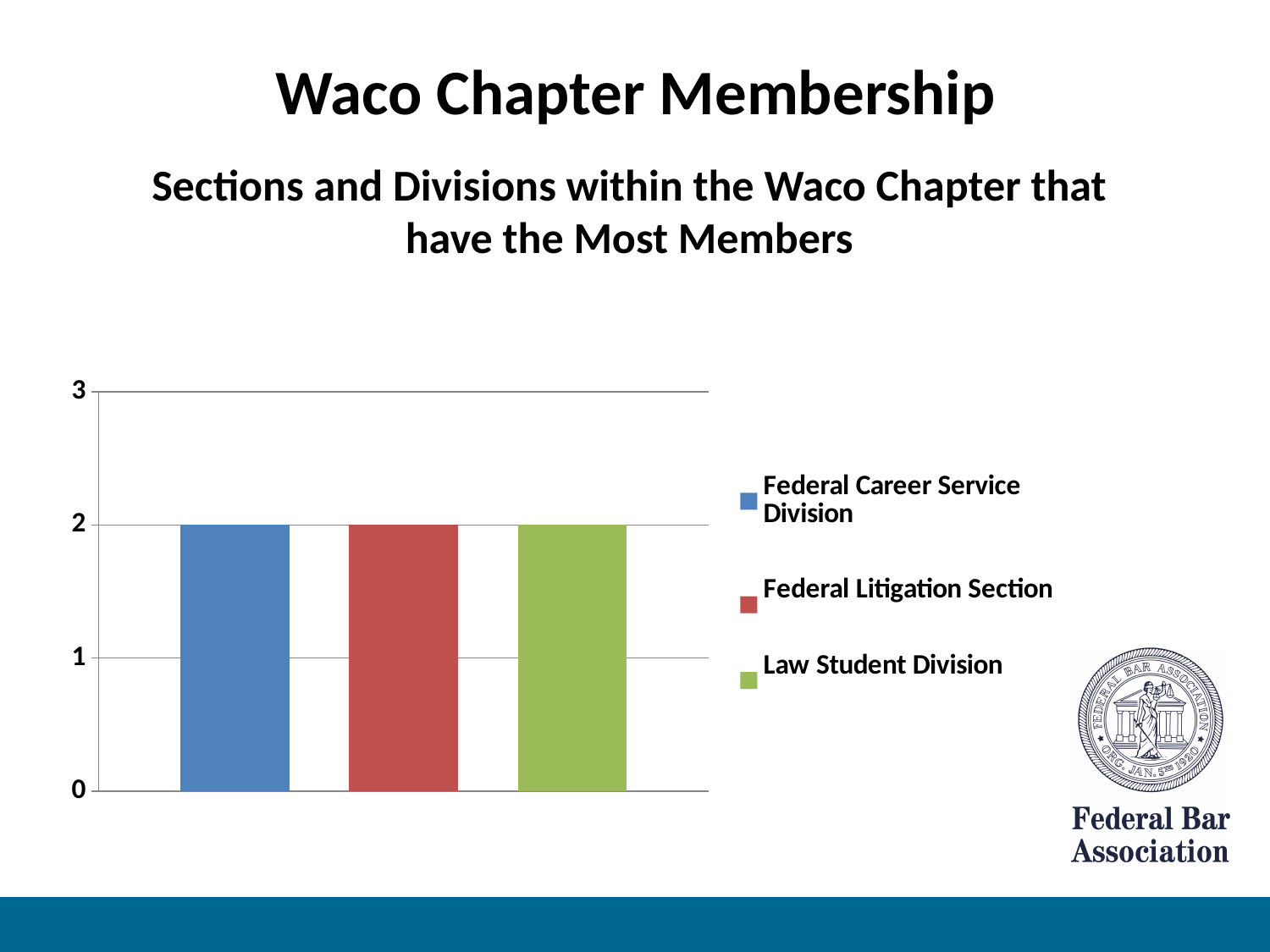
What is the title of the slide? Waco Chapter Membership Which colour represents Federal Litigation Section in the legend? red What kind of chart is shown on the slide? bar chart Is the value for Federal Career Service Division greater or less than 3? less What is the value for Federal Litigation Section? 2 What is the difference between the values for Federal Litigation Section and Law Student Division? 0 How many bars are plotted in the chart? 3 What is the value for Law Student Division? 2 What is the value for Federal Career Service Division? 2 Is the value for Law Student Division greater or less than 1? greater How many entries does the legend list? 3 Do the values rise, fall, or stay flat across the bars from left to right? stay flat